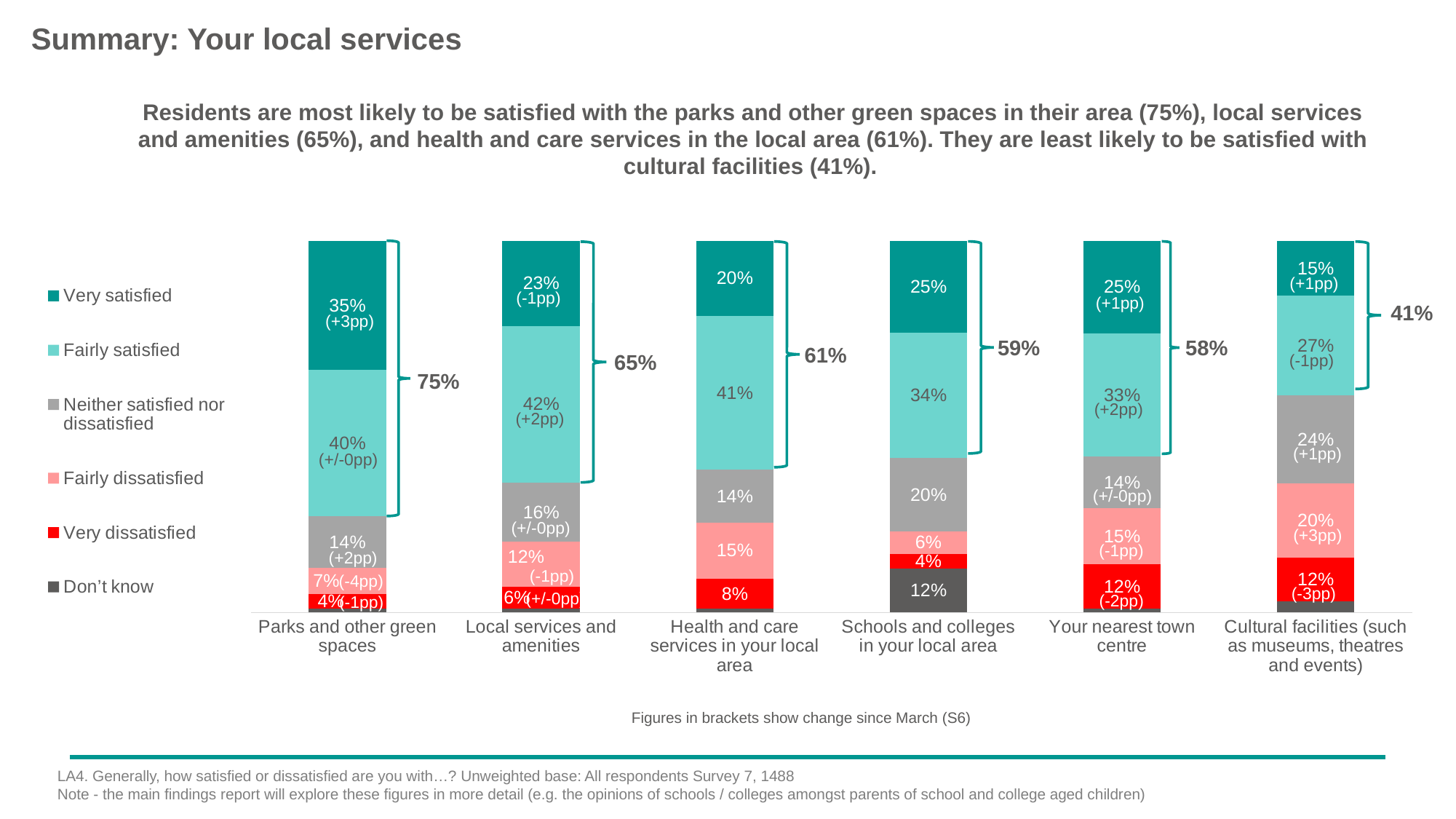
How many categories (local services) are shown on the x axis? 6 Which category has the highest combined satisfied percentage? Parks and other green spaces What is the difference between the combined satisfied percentage for parks and other green spaces and for cultural facilities? 34 percentage points What is the combined satisfied percentage shown for cultural facilities (such as museums, theatres and events)? 41% Which category has the lowest combined satisfied percentage? Cultural facilities (such as museums, theatres and events) How many series does the legend list? 6 What change since March is shown in brackets for the fairly dissatisfied value for parks and other green spaces? -4pp What is the don't know percentage for schools and colleges in your local area? 12% What percentage of residents are very satisfied with parks and other green spaces? 35% What kind of chart is shown on the slide? Stacked bar chart What is the fairly satisfied value for local services and amenities? 42% Which has a larger very dissatisfied share: health and care services in your local area or your nearest town centre? Your nearest town centre